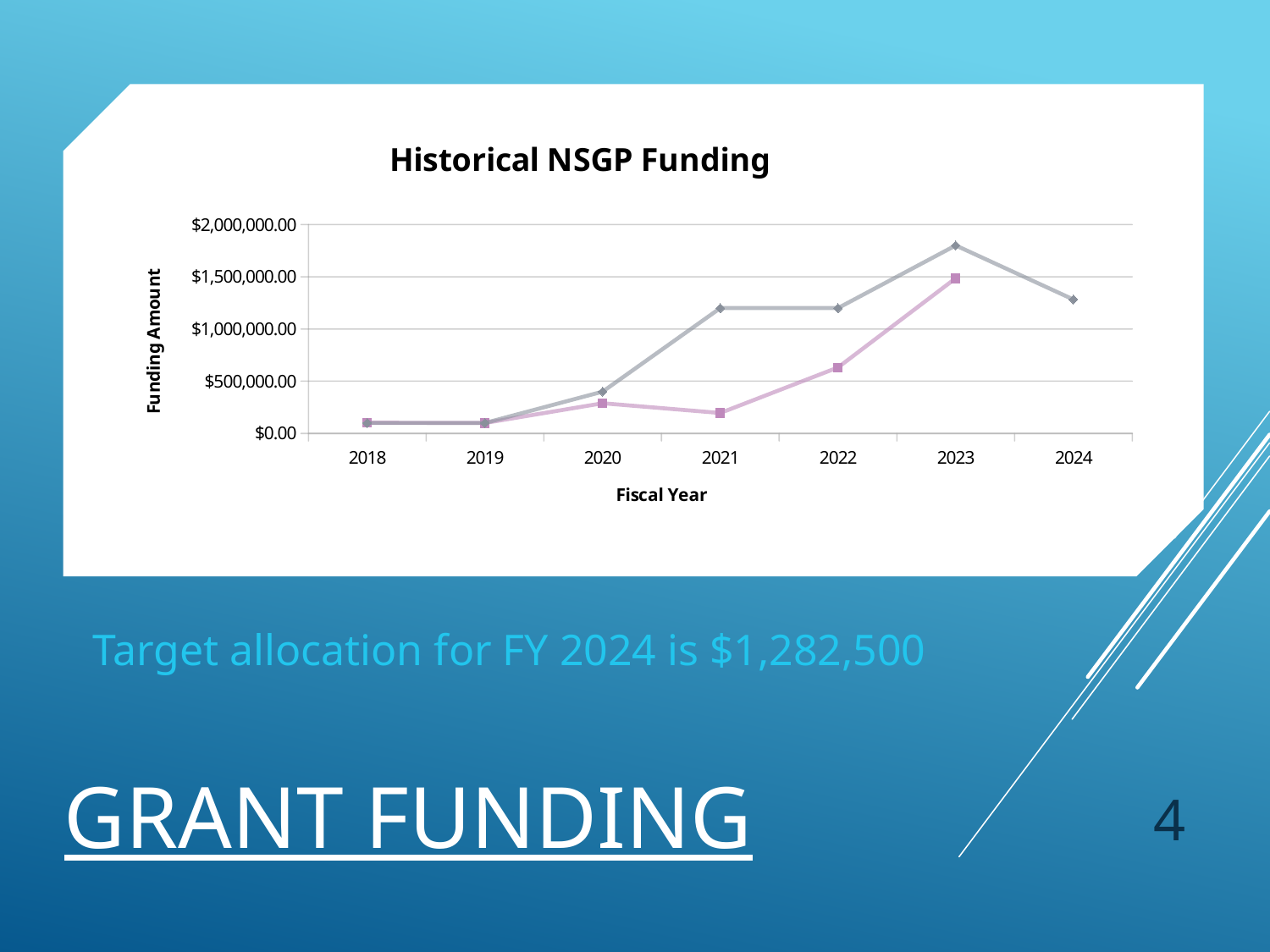
What is the label of the y axis of the chart? Funding Amount Is the value of the gray line for 2023 greater or less than $1,500,000.00? greater In which fiscal year does the gray line reach its highest value? 2023 In 2022, which line has the larger value, the gray line or the pink line? The gray line Does the gray line generally rise or fall from 2018 to 2023? Rise What is the title of the chart? Historical NSGP Funding Is the value of the pink line for 2022 greater or less than $500,000.00? greater Is the value of the gray line for 2020 greater or less than $500,000.00? less How many fiscal years are shown on the x axis of the chart? 7 What type of chart is shown on the slide? Line chart